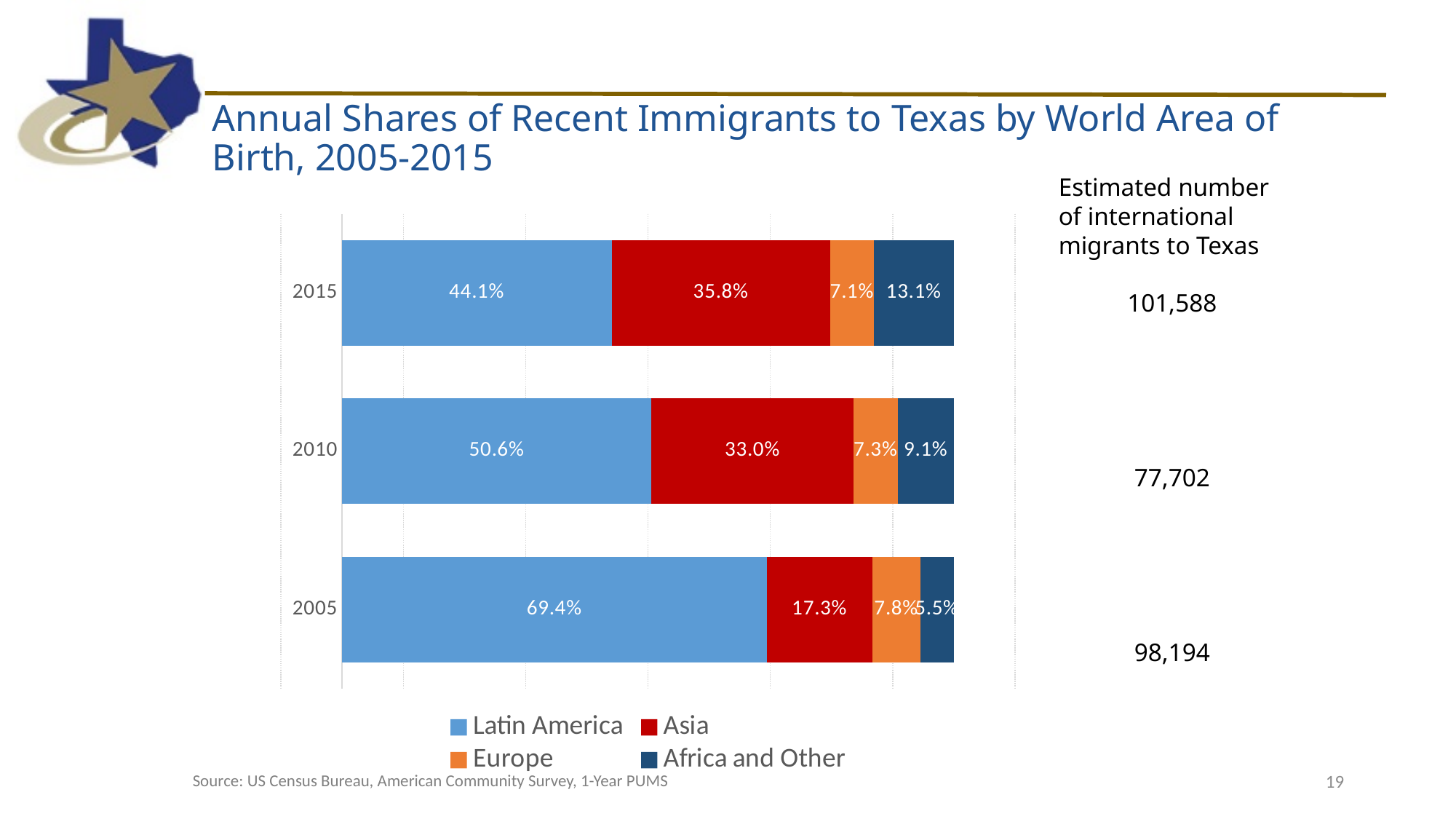
By how many percentage points did the Latin America share fall from 2005 to 2015? 25.3 percentage points In which year was the Africa and Other share the lowest? 2005 What was the share for Africa and Other in 2015? 13.1% How many world areas of birth does the legend list? 4 What kind of chart is shown on the slide? Stacked bar chart Did the Asia share rise or fall from 2005 to 2015? Rise Was the Asia share larger in 2010 or in 2015? 2015 In which year was the Latin America share the highest? 2005 What share of recent immigrants in 2005 were born in Europe? 7.8% What share of recent immigrants to Texas in 2015 were born in Latin America? 44.1% What was the share of immigrants from Asia in 2010? 33.0% How many years are shown in the chart? 3